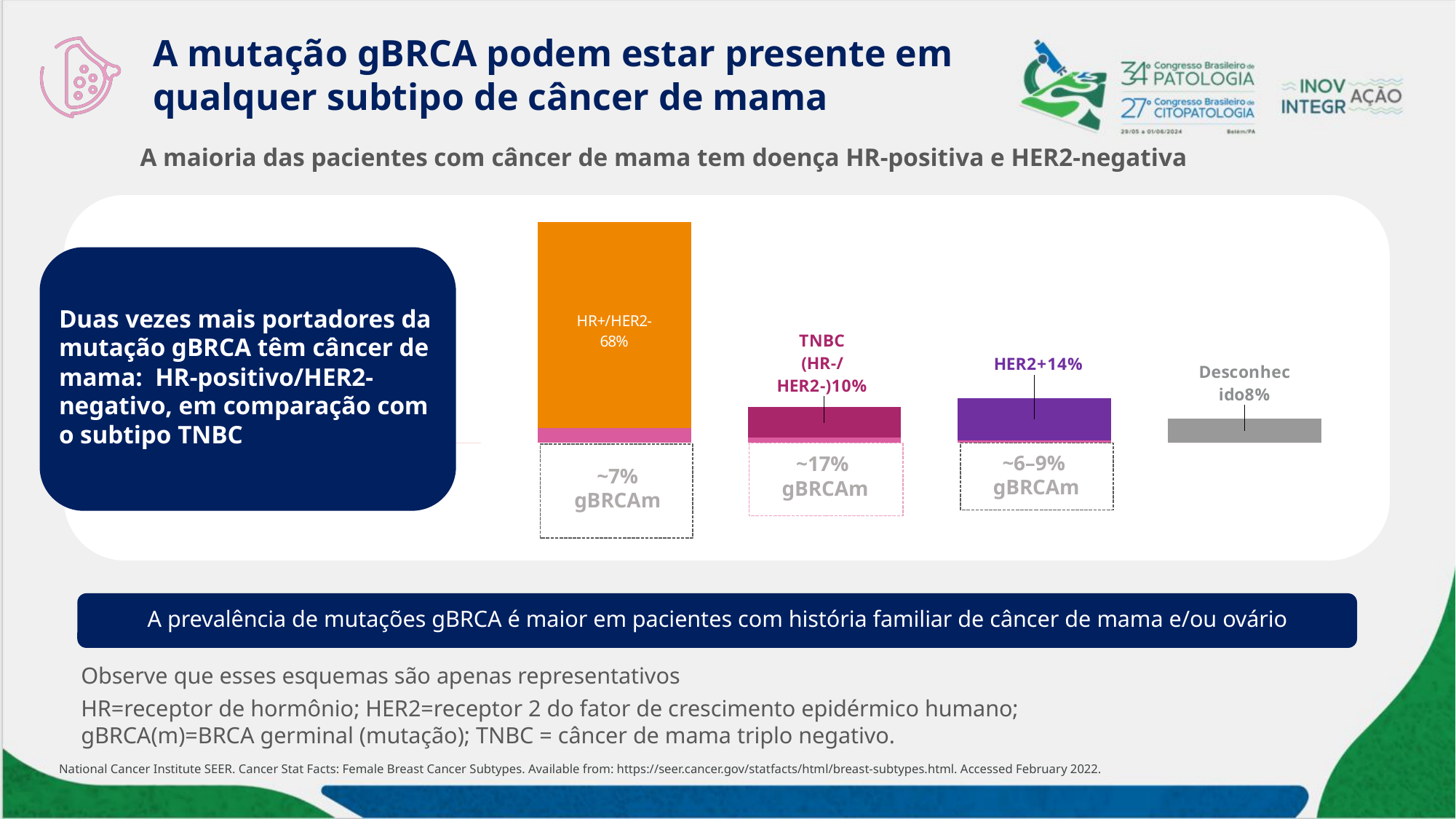
What colour is the bar for the HER2+ subtype? Purple What percentage is shown for the HR+/HER2- subtype? 68% Which has a larger percentage, TNBC (HR-/HER2-) or HER2+? HER2+ What is the difference in percentage between the HR+/HER2- subtype and the HER2+ subtype? 54% What is the difference in percentage between the HER2+ subtype and the TNBC subtype? 4% What percentage is shown for the TNBC (HR-/HER2-) subtype? 10% What percentage is shown for the HER2+ subtype? 14% Which subtype has the lowest percentage in the chart? Desconhecido What percentage is shown for the Desconhecido (unknown) subtype? 8% Which breast cancer subtype has the highest percentage in the chart? HR+/HER2- What kind of chart is used to show the breast cancer subtypes? Bar chart How many breast cancer subtype categories are shown as bars in the chart? 4